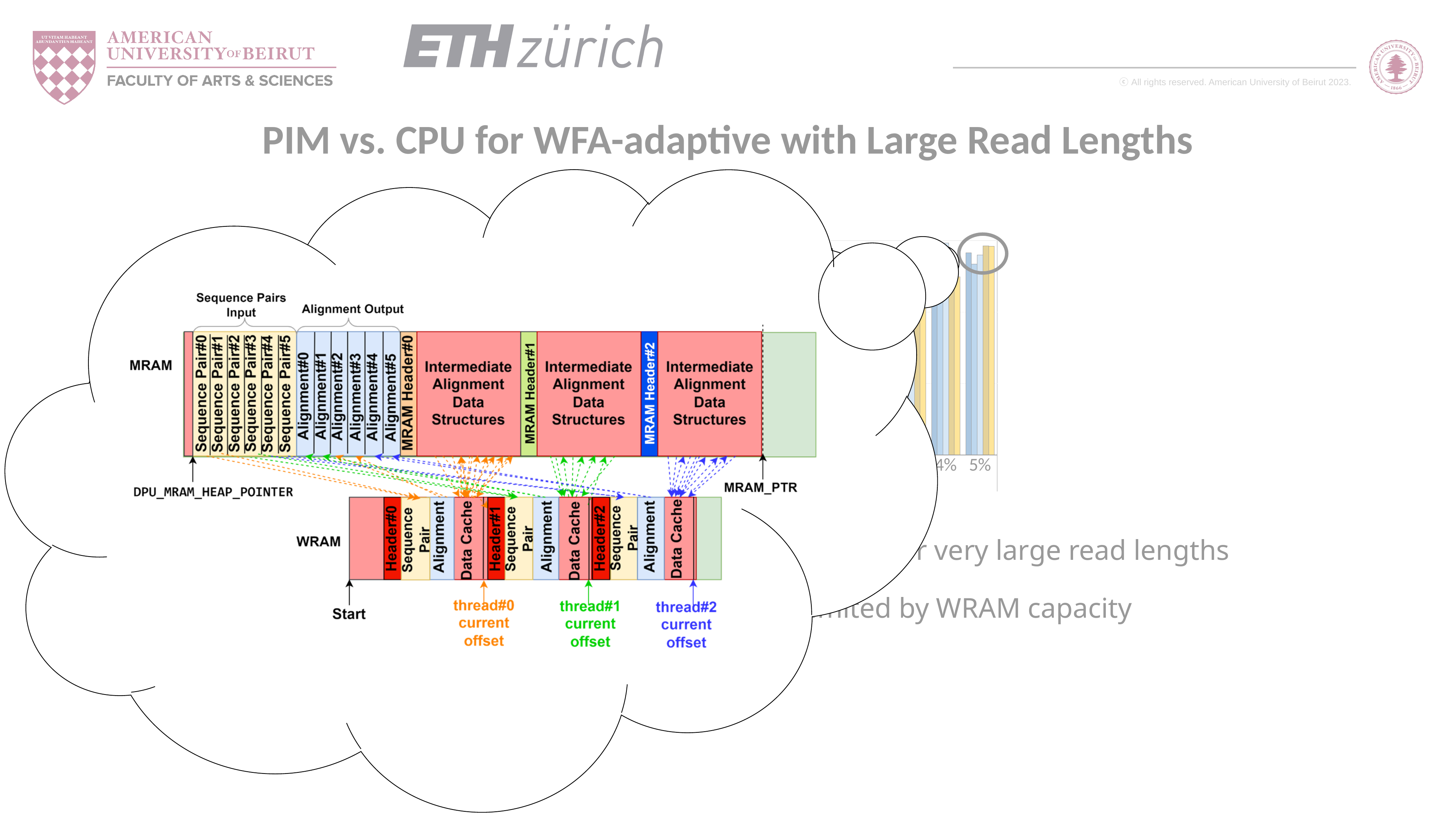
In the partially visible bar chart on the right, which x-axis category is circled? 5% In the partially visible bar chart on the right, which bar is taller at the 5% category, the blue one or the yellow one? the yellow one What kind of chart is partially visible behind the cloud on the right side of the slide? bar chart